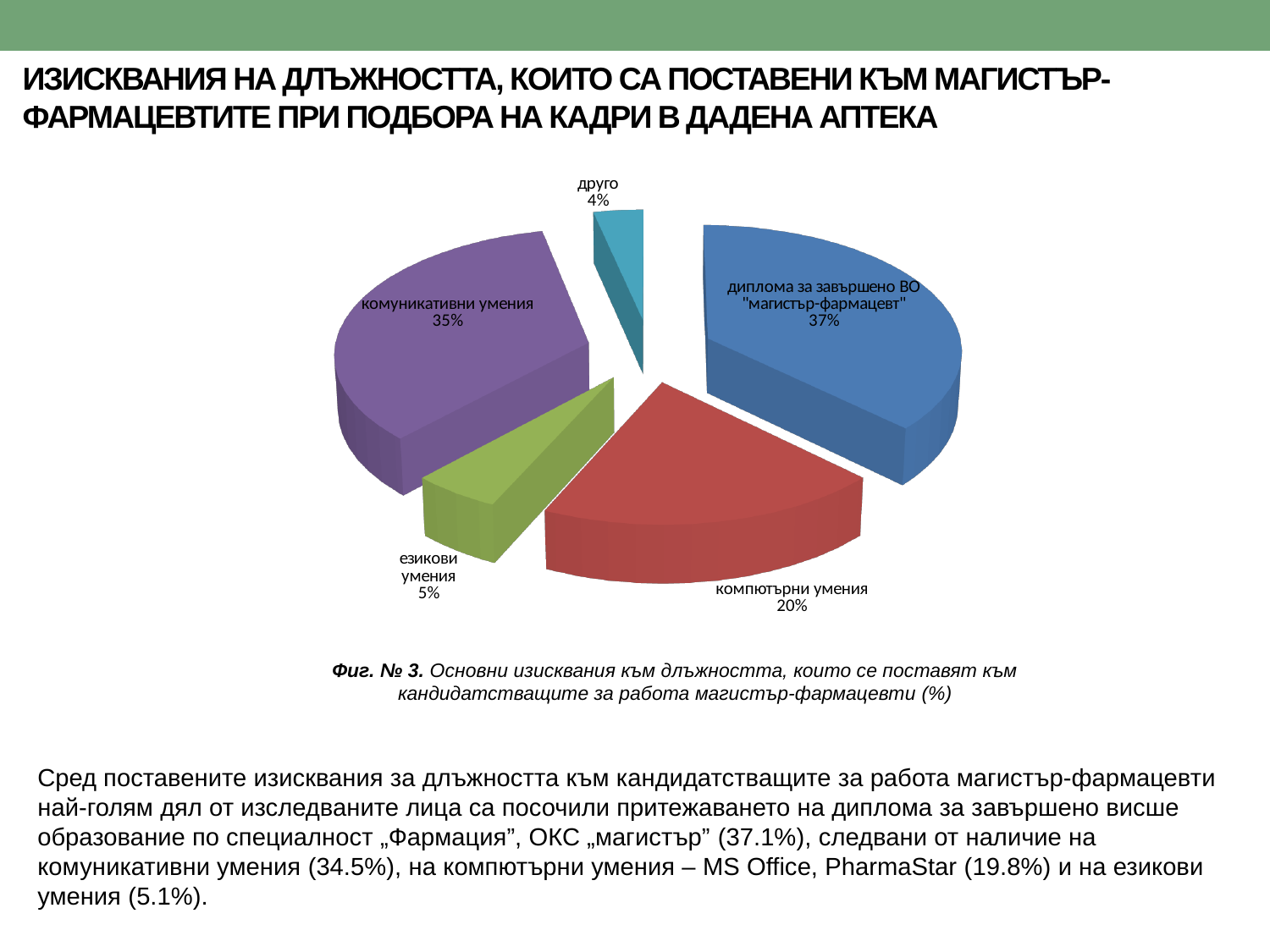
Which is larger: the share for "диплома за завършено ВО "магистър-фармацевт"" or for "комуникативни умения"? диплома за завършено ВО "магистър-фармацевт" How many slices does the pie chart have? 5 What share of the pie is labelled "комуникативни умения"? 35% What is the difference in percentage points between "комуникативни умения" and "компютърни умения"? 15 What percentage is shown for "компютърни умения"? 20% Which category has the largest share of the pie? диплома за завършено ВО "магистър-фармацевт" Which category has the smallest share of the pie? друго What kind of chart is shown on the slide? pie chart What percentage is shown for the slice labelled "друго"? 4% What figure number is given in the caption below the chart? Фиг. № 3 What is the difference in percentage points between "компютърни умения" and "езикови умения"? 15 What percentage is shown for "езикови умения"? 5%